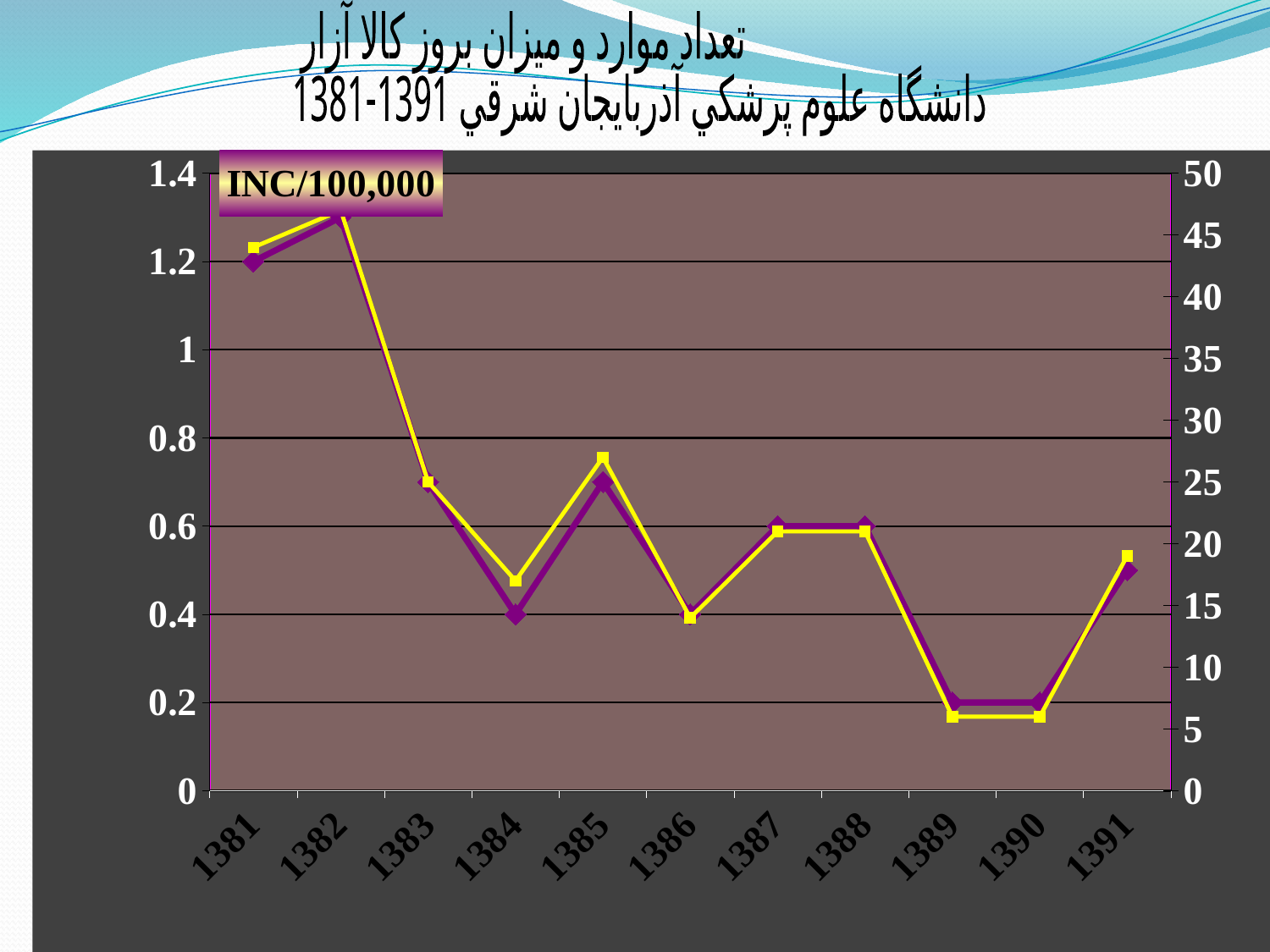
Reading the yellow line against the left axis, is the value for 1389 greater or less than 0.4? less Is the yellow line higher in 1384 or in 1385? 1385 How many years are shown along the x axis of the chart? 11 Overall, do the plotted values rise or fall from 1381 to 1391? fall Reading the yellow line against the left axis, is the value for 1381 greater or less than 1? greater What is the highest tick value on the right-hand y axis? 50 What kind of chart is shown on the slide? line chart How many data series are plotted on the chart? 2 Reading the purple line against the right axis, is the value for 1382 greater or less than 40? greater In which year do both lines reach their peak? 1382 What is the first year shown on the x axis? 1381